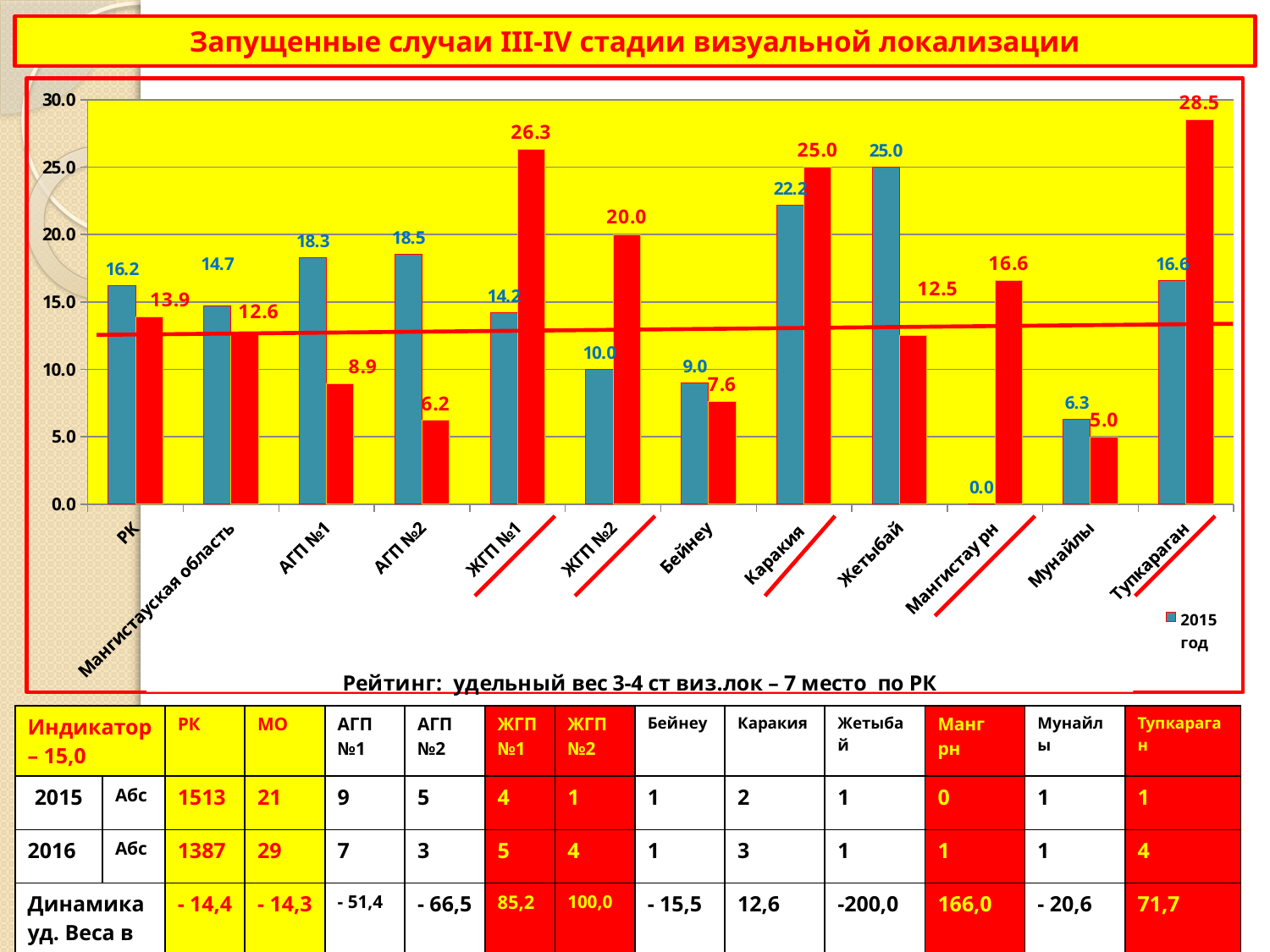
Is the value of the red bar for Жетыбай greater or less than 15.0? less For АГП №2, which is larger: the 2015 год bar or the red bar? the 2015 год bar How many categories are shown on the x axis of the chart? 12 What kind of chart is shown on the slide? bar chart What is the value of the red bar for Тупкараган? 28.5 Which category has the highest red bar? Тупкараган Which category has the highest value in the 2015 год series? Жетыбай Which category has the lowest value in the 2015 год series? Мангистау рн What is the value of the 2015 год series for Каракия? 22.2 What is the value of the red bar for Мангистау рн? 16.6 What is the value of the 2015 год series for Мунайлы? 6.3 For ЖГП №1, what is the difference between the red bar and the 2015 год bar? 12.1